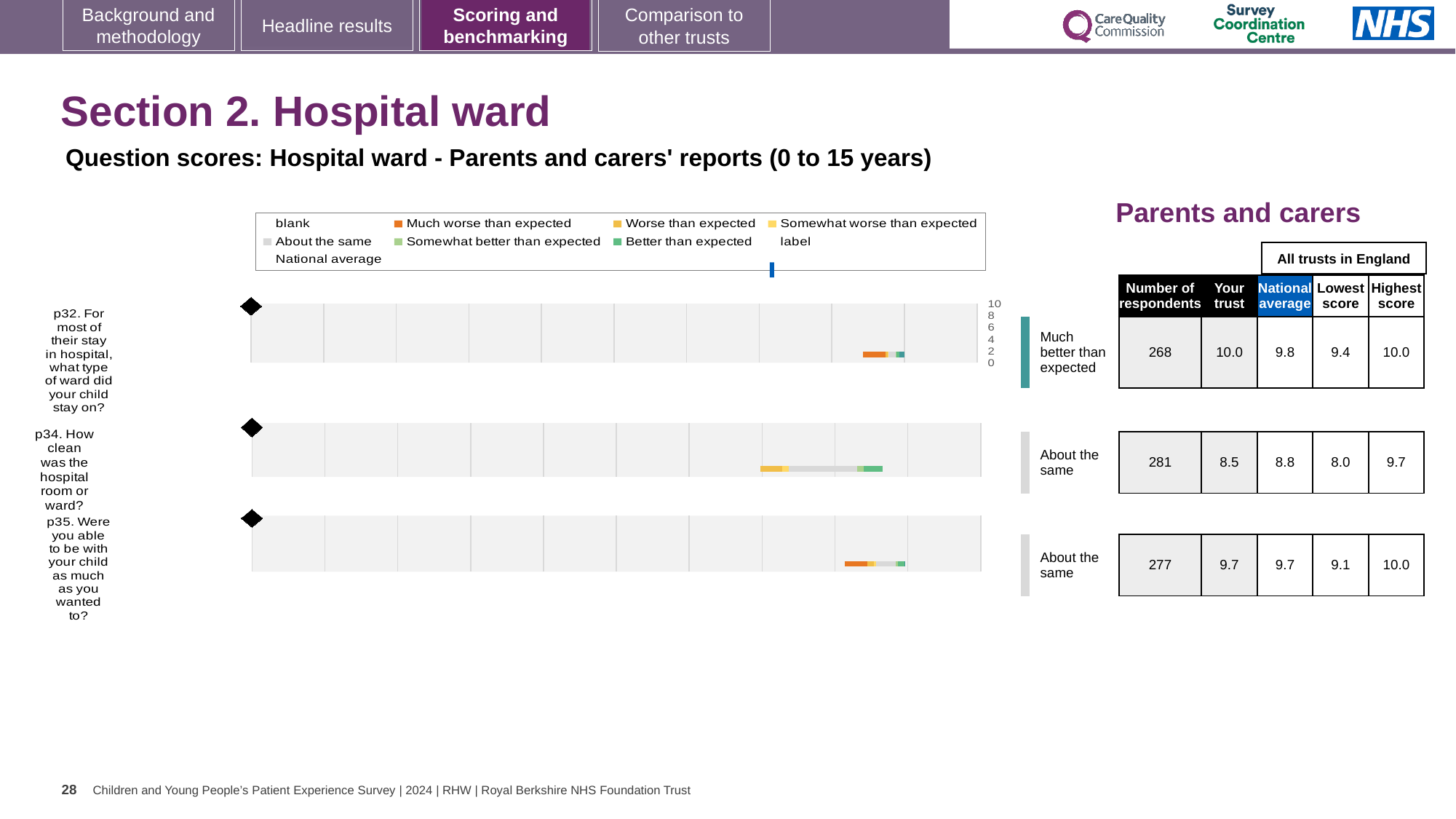
What is the difference between the 'Your trust' scores for p32 and p34? 1.5 How many questions are plotted in the chart? 3 How many respondents are listed for p34 (how clean was the hospital room or ward)? 281 Which question has the highest 'Your trust' score? p32 What is the national average score for p35 (were you able to be with your child as much as you wanted to)? 9.7 For p34, which is larger: the 'Your trust' score or the national average? National average What is the 'Your trust' score for p32 (what type of ward did your child stay on)? 10.0 What colour represents 'Much worse than expected' in the legend? Orange Which benchmark category is shown for p32? Much better than expected What is the lowest score across all trusts in England for p34? 8.0 What kind of chart is used to show the question scores on this slide? bar chart Which question has the lowest 'Your trust' score? p34